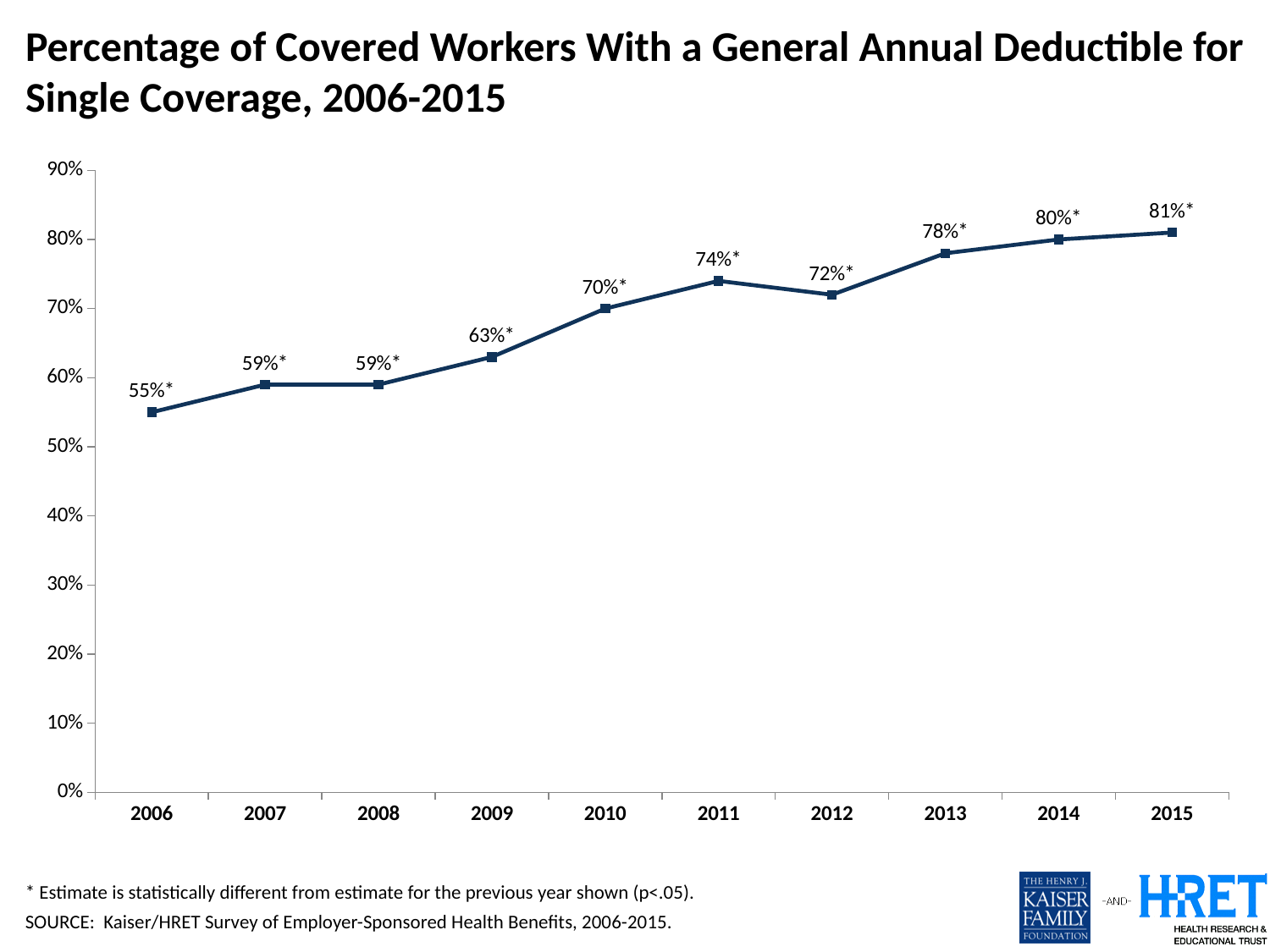
What is the value shown for 2015? 81% What is the overall trend of the values from 2006 to 2015? Rising What kind of chart is shown on the slide? Line chart What is the value shown for 2012? 72% By how many percentage points did the value change from 2006 to 2015? 26 percentage points Which year has the highest percentage of covered workers with a general annual deductible? 2015 What is the difference between the 2011 value and the 2012 value? 2 percentage points Which year has a higher value, 2011 or 2012? 2011 Is the value for 2010 greater or less than 60%? greater Which year has the lowest percentage of covered workers with a general annual deductible? 2006 What percentage of covered workers had a general annual deductible for single coverage in 2006? 55% How many years are plotted on the chart? 10